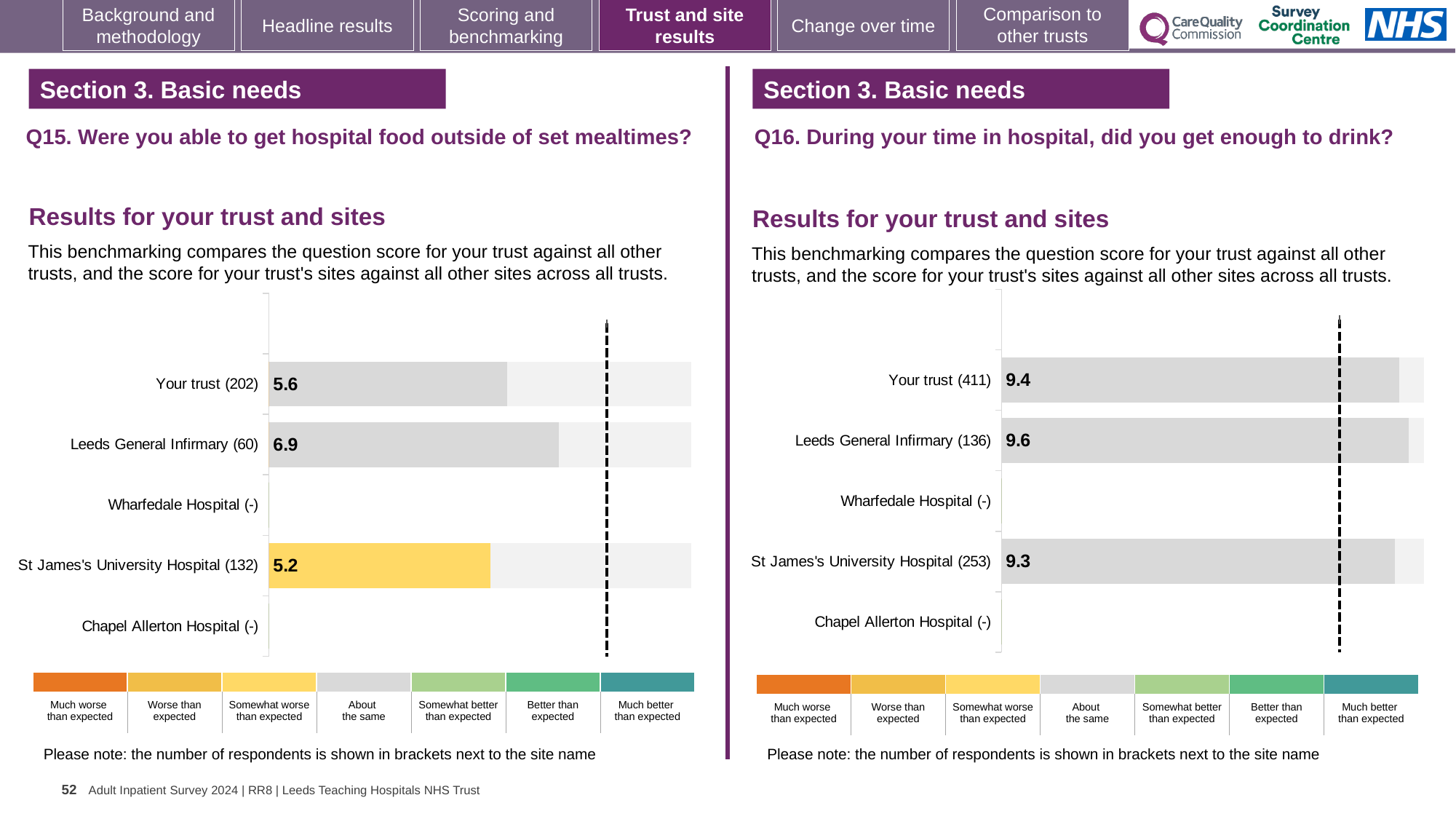
On the Q16 chart (right), what is the score for Leeds General Infirmary? 9.6 On the Q15 chart (left), what is the score for Your trust? 5.6 On the Q16 chart (right), which site or trust has the lowest score among those with a value shown? St James's University Hospital On the Q15 chart (left), what is the score for St James's University Hospital? 5.2 On the Q15 chart (left), what is the score for Leeds General Infirmary? 6.9 On the Q15 chart (left), what is the difference between the scores for Leeds General Infirmary and St James's University Hospital? 1.7 On the Q15 chart (left), which site or trust has the highest score? Leeds General Infirmary On the Q16 chart (right), what is the difference between the scores for Leeds General Infirmary and Your trust? 0.2 What kind of chart is used on the Q15 chart (left)? Bar chart On the Q15 chart (left), how many respondents are shown in brackets for St James's University Hospital? 132 On the Q16 chart (right), what is the score for Your trust? 9.4 On the Q16 chart (right), what is the score for St James's University Hospital? 9.3